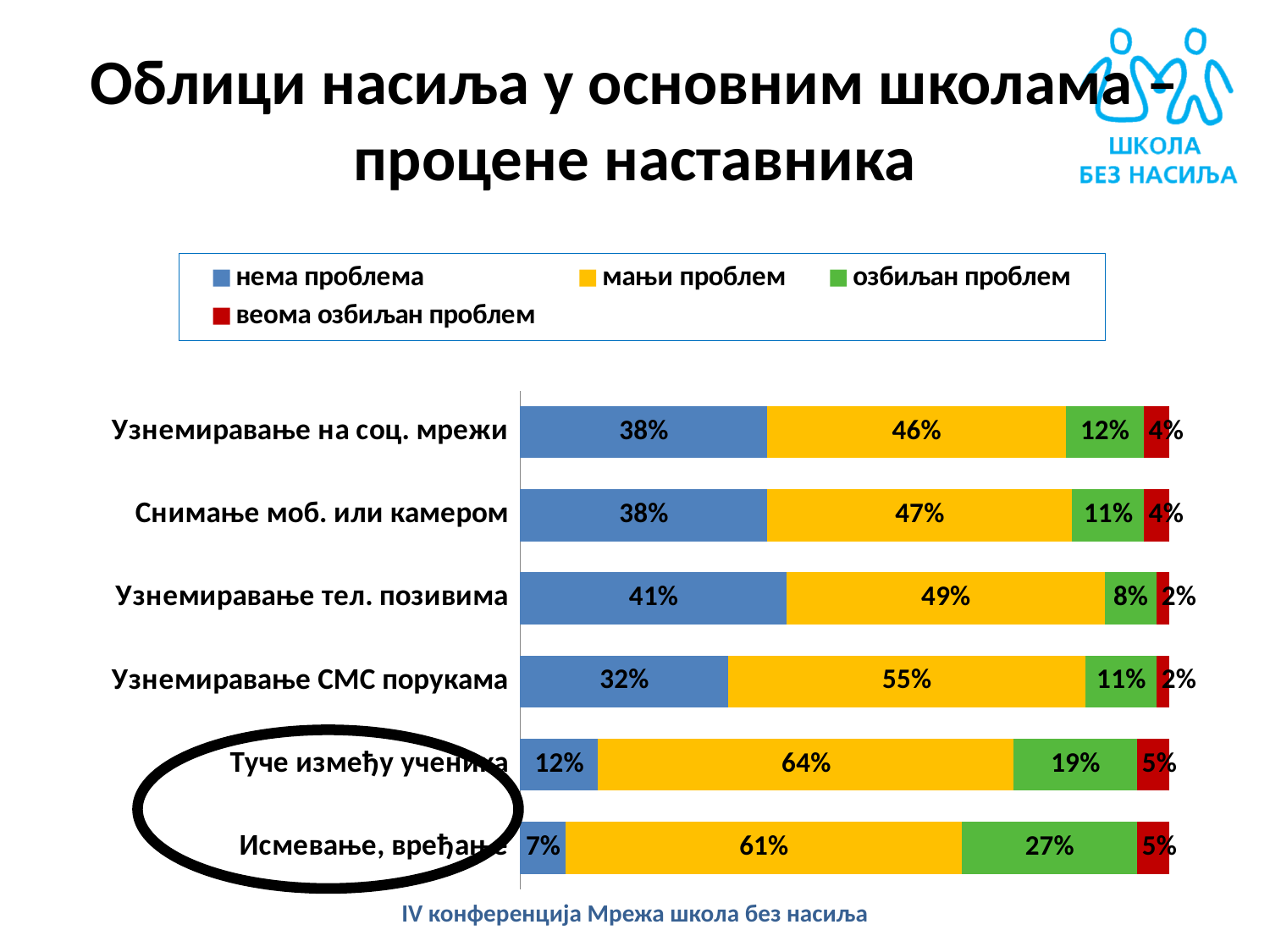
How many series does the legend list? 4 How many categories are plotted on the chart? 6 What type of chart is shown on the slide? stacked bar chart What is the value of 'мањи проблем' for 'Туче између ученика'? 64% Which is larger: the 'озбиљан проблем' value for 'Туче између ученика' or for 'Узнемиравање СМС порукама'? Туче између ученика What is the difference between the 'мањи проблем' values for 'Узнемиравање СМС порукама' and 'Узнемиравање на соц. мрежи'? 9% What is the value of 'озбиљан проблем' for 'Исмевање, вређање'? 27% Which category has the highest value for 'озбиљан проблем'? Исмевање, вређање Which legend entry is shown in red? веома озбиљан проблем What is the value of 'нема проблема' for 'Узнемиравање тел. позивима'? 41% What is the value of 'веома озбиљан проблем' for 'Снимање моб. или камером'? 4% Which category has the lowest value for 'нема проблема'? Исмевање, вређање